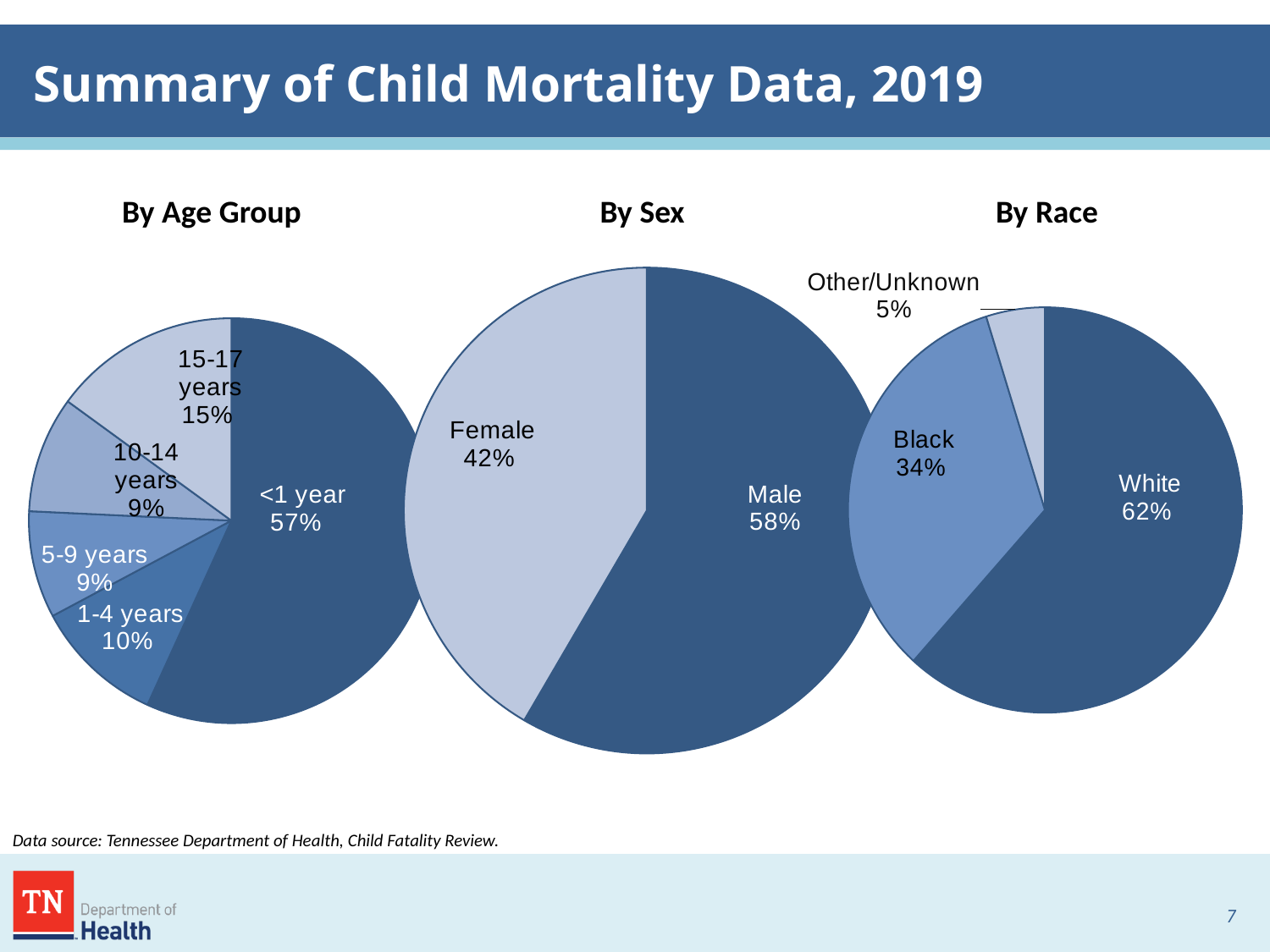
In the 'By Race' pie chart, what is the share for Black? 34% In the 'By Sex' pie chart, what is the share for Male? 58% In the 'By Age Group' pie chart, what is the difference between the <1 year share and the 15-17 years share? 42% What type of chart is used for the 'By Race' data? Pie chart In the 'By Race' pie chart, which category has the smallest share? Other/Unknown In the 'By Age Group' pie chart, how many age groups are shown? 5 In the 'By Age Group' pie chart, what is the share for the 15-17 years group? 15% In the 'By Sex' pie chart, what is the difference between the Male and Female shares? 16% In the 'By Sex' pie chart, which is larger, Male or Female? Male In the 'By Age Group' pie chart, what share of child deaths is for the <1 year group? 57% In the 'By Age Group' pie chart, which age group has the largest share? <1 year In the 'By Race' pie chart, what is the difference between the White and Black shares? 28%